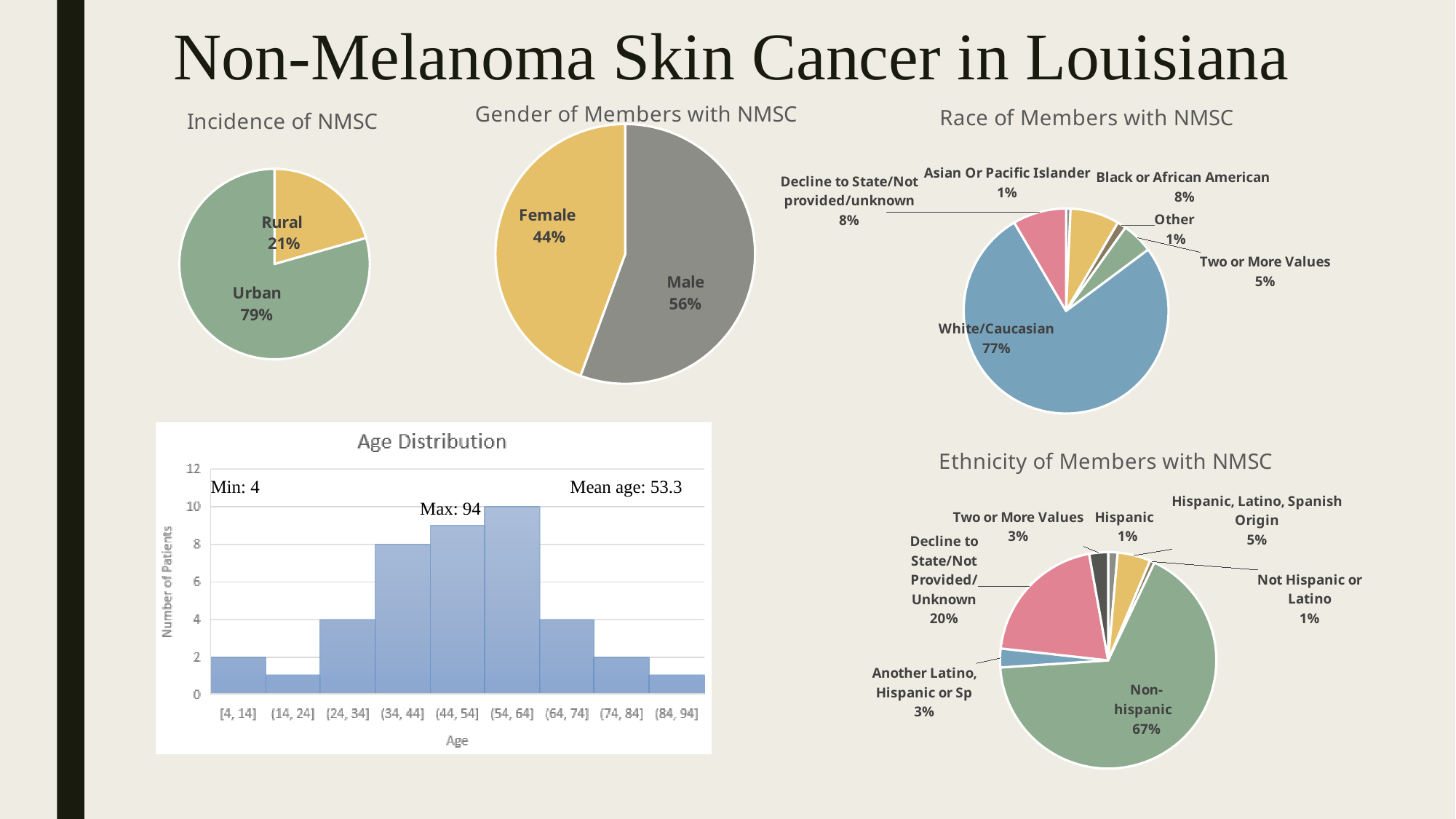
In the Age Distribution chart, how many age groups are shown on the x axis? 9 In the Ethnicity of Members with NMSC pie chart, which is larger: Two or More Values or Hispanic, Latino, Spanish Origin? Hispanic, Latino, Spanish Origin In the Race of Members with NMSC pie chart, how many categories are shown? 6 In the Age Distribution chart, how many patients are in the (54, 64] age group? 10 In the Gender of Members with NMSC pie chart, what percentage is Male? 56% In the Ethnicity of Members with NMSC pie chart, what share is Decline to State/Not Provided/Unknown? 20% In the Age Distribution chart, is the number of patients in the (44, 54] age group greater or less than 8? greater In the Incidence of NMSC pie chart, what share is Urban? 79% What kind of chart is the Age Distribution chart? Bar chart In the Race of Members with NMSC pie chart, what share is Black or African American? 8% In the Gender of Members with NMSC pie chart, what is the difference between the Male and Female shares? 12% In the Race of Members with NMSC pie chart, which category has the largest share? White/Caucasian